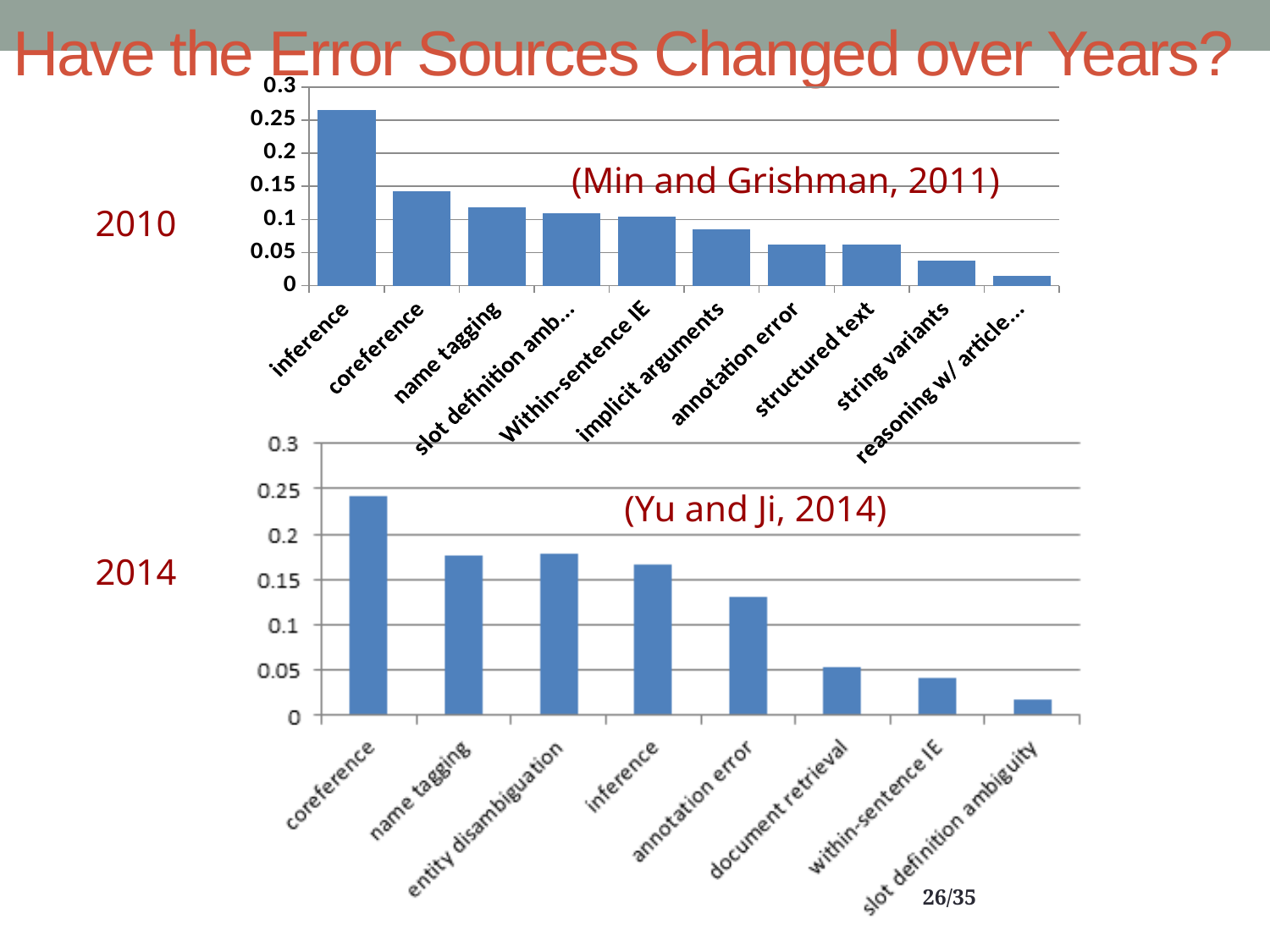
In the 2014 chart, which error source has the lowest value? slot definition ambiguity In the 2010 chart, which is larger, the value for coreference or the value for string variants? coreference Which paper is cited as the source of the 2014 chart? (Yu and Ji, 2014) In the 2010 chart, is the value for inference greater or less than 0.25? greater In the 2014 chart, is the value for document retrieval greater or less than 0.1? less What kind of chart is the 2014 chart? bar chart How many error source categories are shown in the 2014 chart? 8 In the 2014 chart, is the value for annotation error greater or less than 0.1? greater In the 2014 chart, which error source has the highest value? coreference In the 2010 chart, which error source has the highest value? inference In the 2014 chart, do the values rise or fall from left to right along the x axis? fall How many error source categories are shown in the 2010 chart? 10